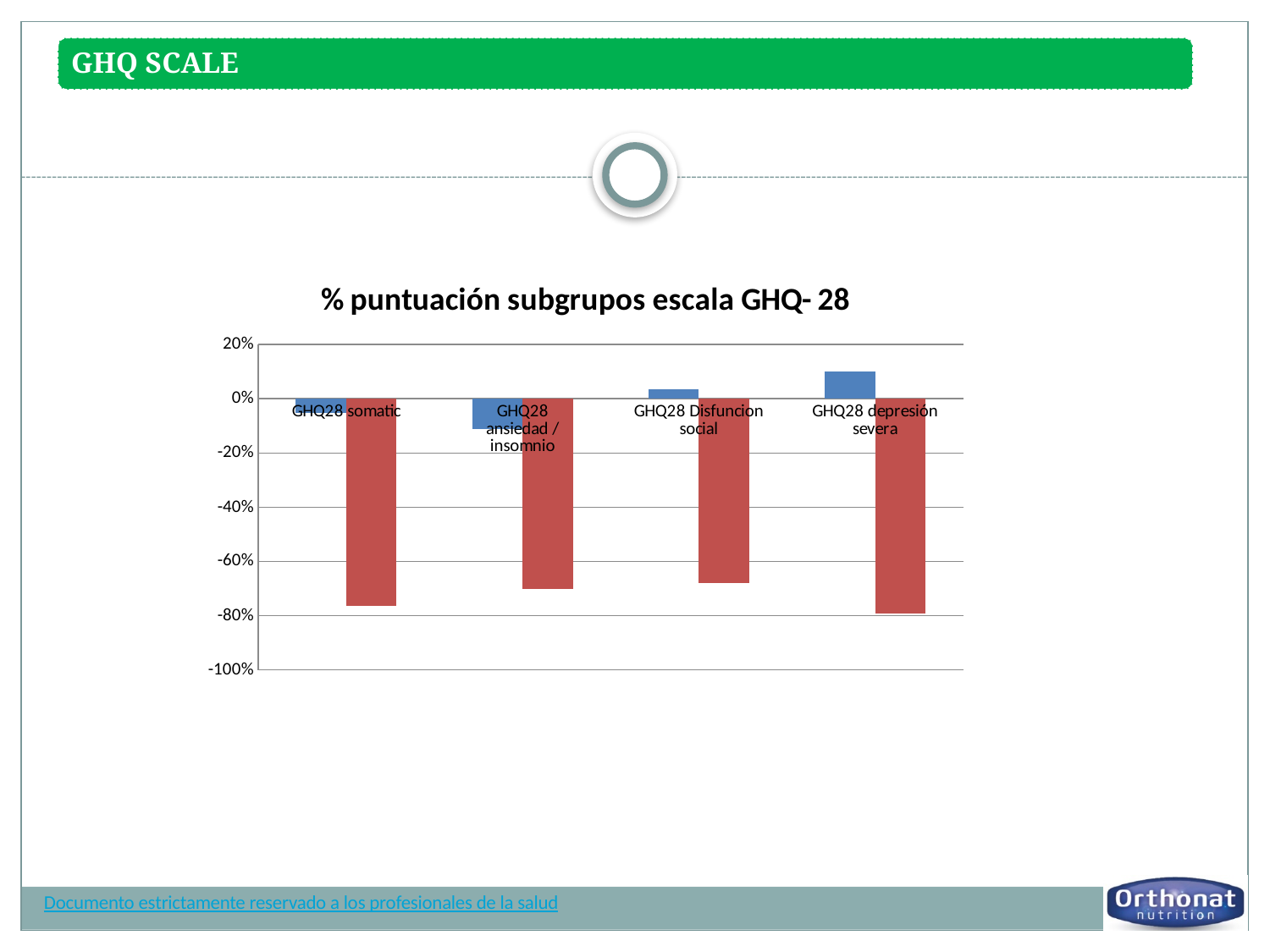
What two colours are used for the bars in the chart? blue and red Is the red bar for GHQ28 Disfuncion social greater or less than -60%? less What is the title of the chart? % puntuación subgrupos escala GHQ- 28 Is the blue bar for GHQ28 depresión severa greater or less than 0%? greater Which category has the lowest blue bar? GHQ28 ansiedad / insomnio Which category has the highest blue bar? GHQ28 depresión severa Is the red bar for GHQ28 somatic greater or less than -60%? less Which red bar is lower, GHQ28 depresión severa or GHQ28 Disfuncion social? GHQ28 depresión severa How many categories are shown on the x axis of the chart? 4 What kind of chart is shown on the slide? bar chart